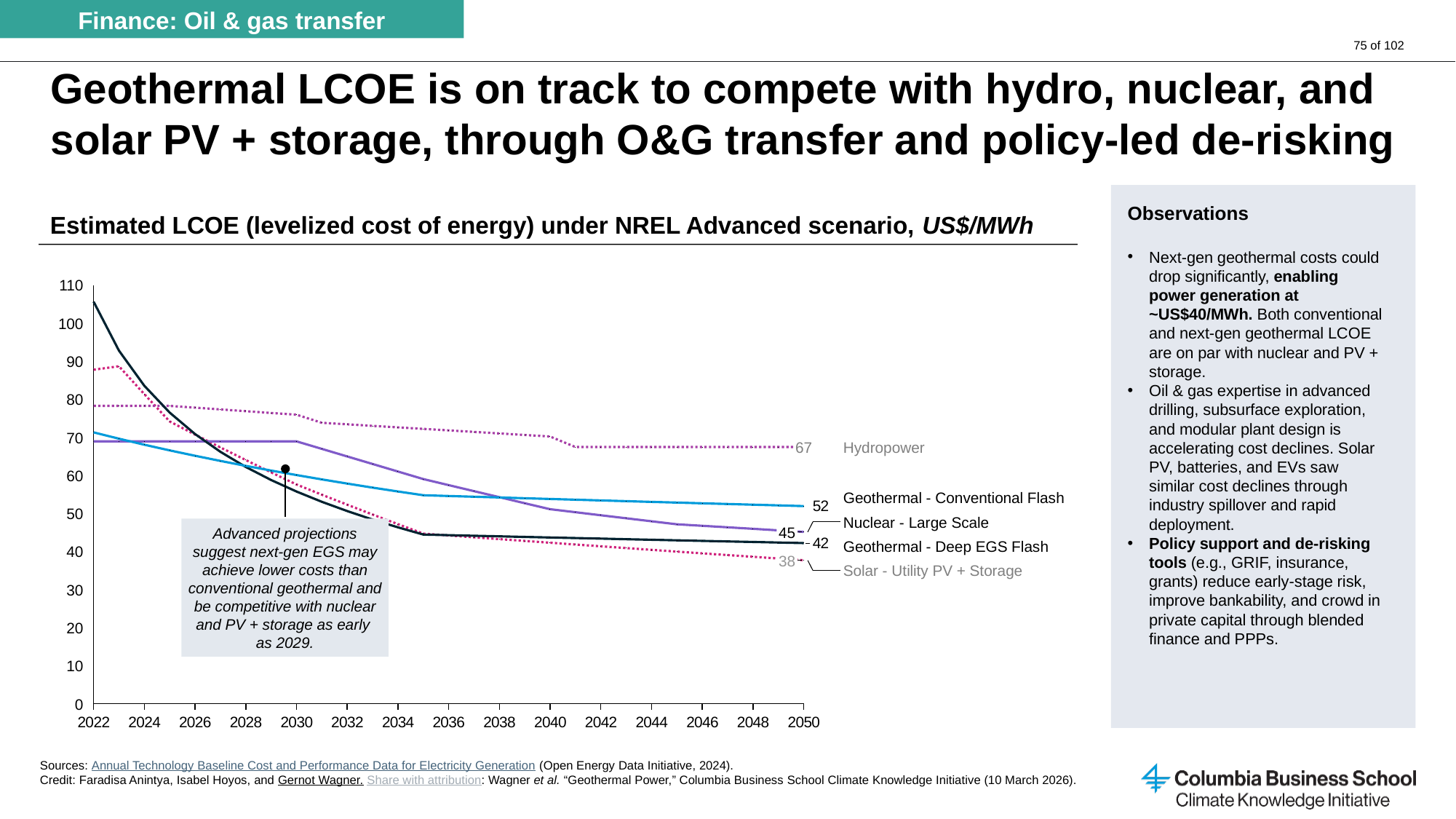
In 2050, which is larger: Nuclear - Large Scale or Geothermal - Deep EGS Flash? Nuclear - Large Scale What is the 2050 value for Solar - Utility PV + Storage? 38 What is the 2050 value for Hydropower? 67 Which series has the highest value in 2050? Hydropower Does the Geothermal - Deep EGS Flash line rise or fall from 2022 to 2050? fall What is the 2050 value for Geothermal - Deep EGS Flash? 42 Is the 2022 value for Geothermal - Deep EGS Flash greater or less than 100? greater What is the 2050 value for Geothermal - Conventional Flash? 52 How many series are labelled on the chart? 5 What kind of chart is shown on the slide? line chart Which series has the lowest value in 2050? Solar - Utility PV + Storage What is the difference between the 2050 values for Hydropower and Solar - Utility PV + Storage? 29